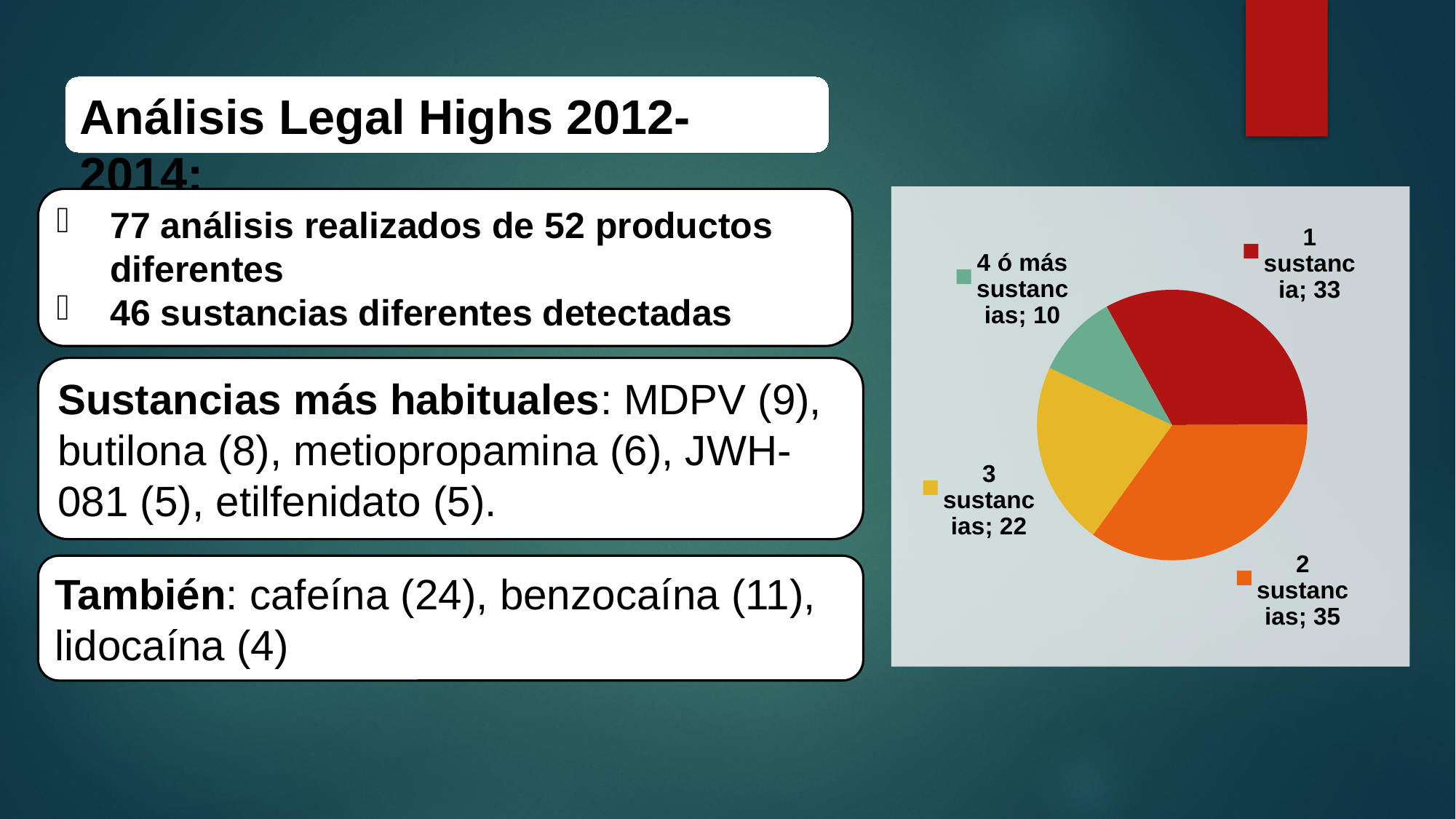
What colour is the slice for "4 ó más sustancias"? green What is the value for "4 ó más sustancias" in the pie chart? 10 What is the difference between the values for "2 sustancias" and "3 sustancias"? 13 Which category has the largest slice in the pie chart? 2 sustancias What is the value for "1 sustancia" in the pie chart? 33 What is the value for "3 sustancias" in the pie chart? 22 What is the total of all the values shown in the pie chart? 100 What kind of chart is shown on the slide? pie chart Which is larger, the value for "3 sustancias" or the value for "4 ó más sustancias"? 3 sustancias How many slices does the pie chart have? 4 What is the value for "2 sustancias" in the pie chart? 35 Which category has the smallest slice in the pie chart? 4 ó más sustancias